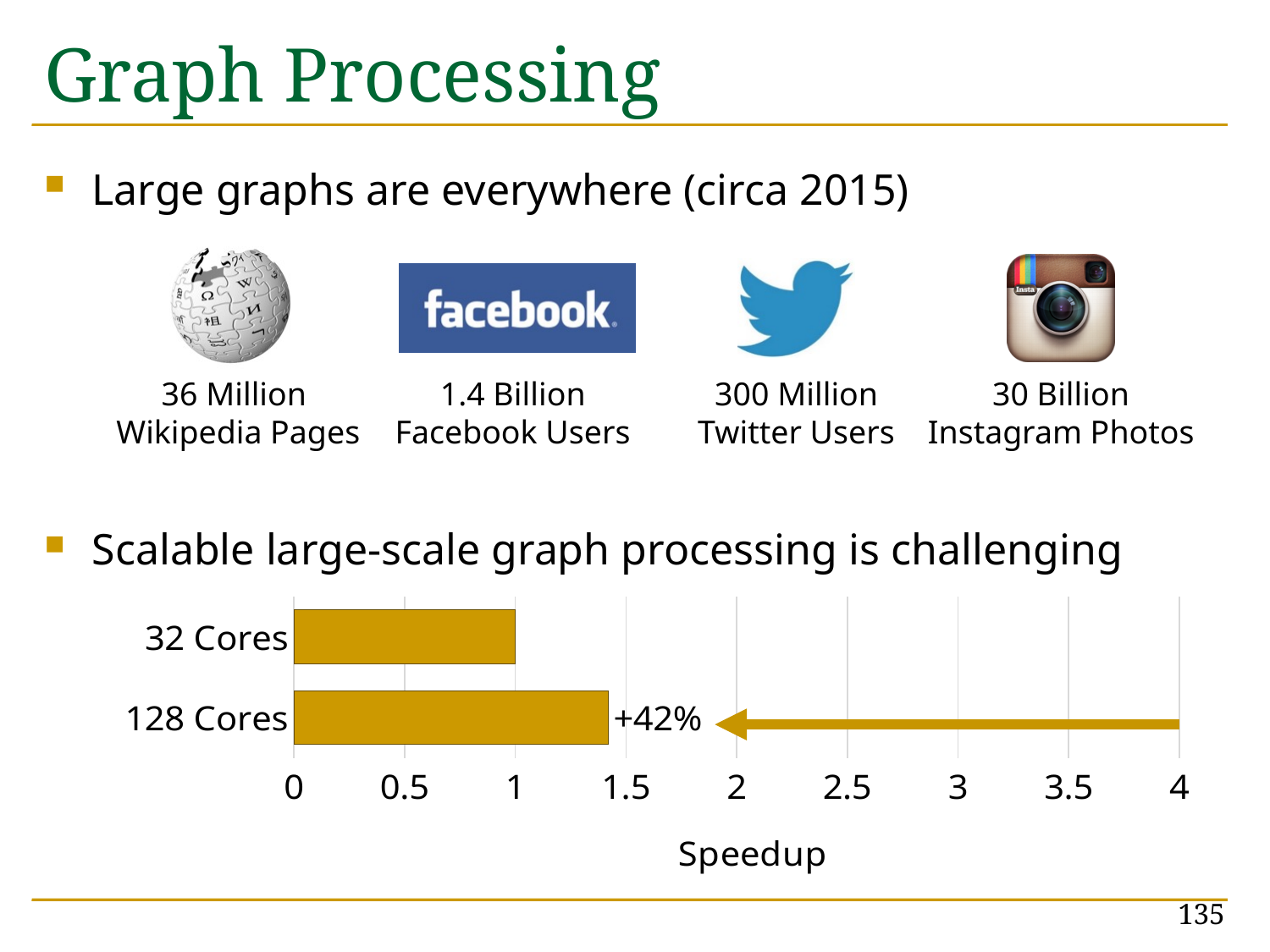
What is the speedup value for 32 Cores? 1 Is the speedup for 128 Cores greater or less than 2? less Which category has the highest speedup in the bar chart? 128 Cores Is the speedup for 32 Cores greater or less than 1.5? less Is the speedup for 128 Cores greater or less than 1? greater What is the label on the x axis of the bar chart? Speedup What kind of chart is shown at the bottom of the slide? bar chart What annotation is printed next to the 128 Cores bar? +42% What is the maximum value shown on the x axis of the bar chart? 4 Which has a larger speedup, 32 Cores or 128 Cores? 128 Cores Which category has the lowest speedup in the bar chart? 32 Cores How many categories does the Speedup bar chart show? 2